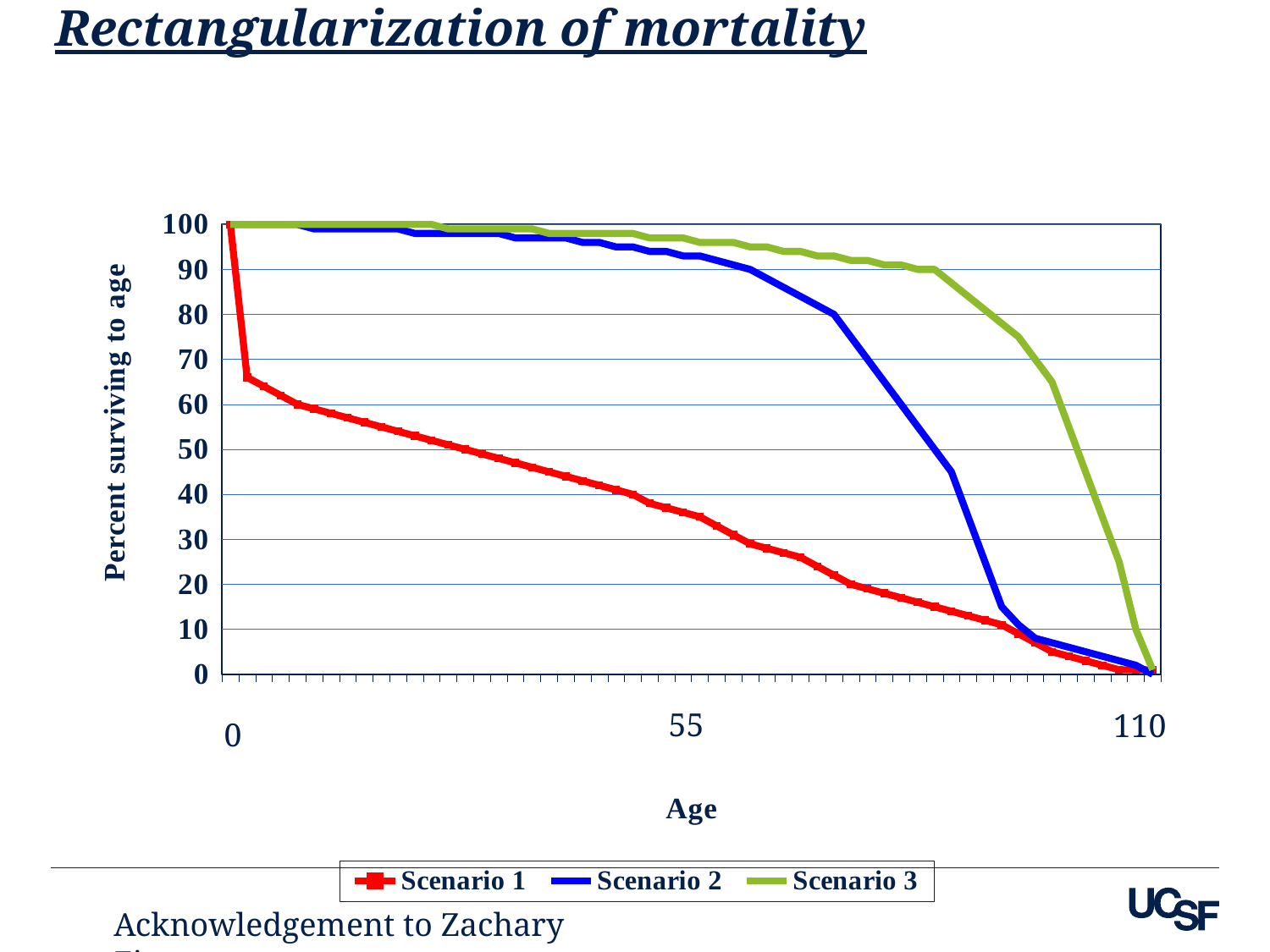
What is the title of the chart on the slide? Rectangularization of mortality What is the highest age shown on the x axis? 110 What is the label of the vertical axis? Percent surviving to age Is the value for Scenario 2 at age 55 greater or less than 80? greater At age 55, which is larger: the value for Scenario 1 or the value for Scenario 2? Scenario 2 What kind of chart is shown on the slide? line chart Is the value for Scenario 1 at age 55 greater or less than 40? less Do the values for Scenario 1 rise or fall as age increases? fall Which scenario has the lowest percent surviving at age 55? Scenario 1 Is the value for Scenario 3 at age 55 greater or less than 90? greater How many series does the legend list? 3